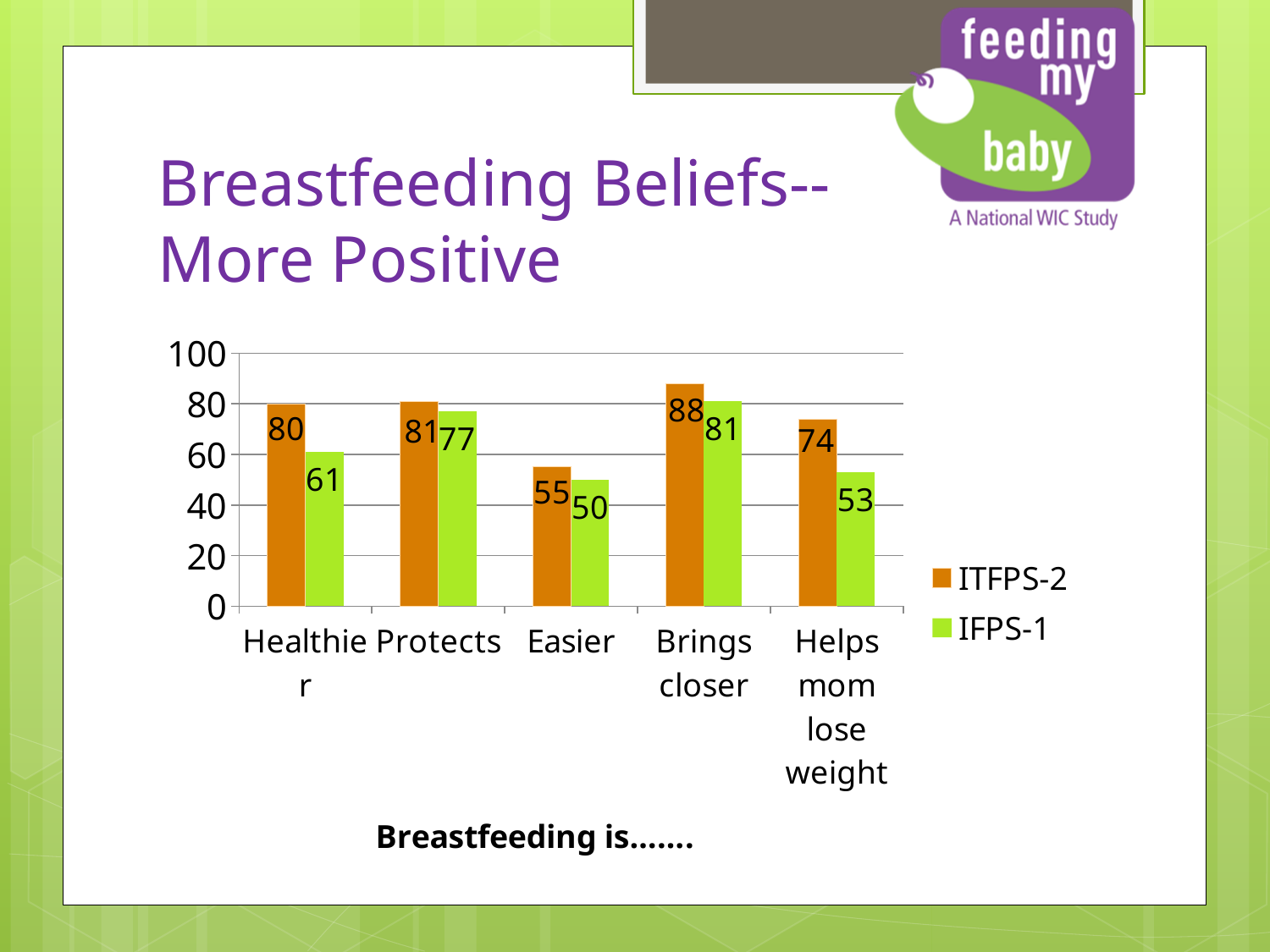
How many series does the legend list? 2 What is the ITFPS-2 value for "Healthier"? 80 What is the IFPS-1 value for "Helps mom lose weight"? 53 What is the IFPS-1 value for "Protects"? 77 Which category has the lowest IFPS-1 value? Easier What is the difference between the ITFPS-2 and IFPS-1 values for "Helps mom lose weight"? 21 Which is larger for "Easier": the ITFPS-2 value or the IFPS-1 value? ITFPS-2 What is the x-axis title of the chart? Breastfeeding is....... What kind of chart is shown on the slide? Bar chart What is the difference between the ITFPS-2 and IFPS-1 values for "Healthier"? 19 Which category has the highest ITFPS-2 value? Brings closer How many categories are shown on the x axis? 5